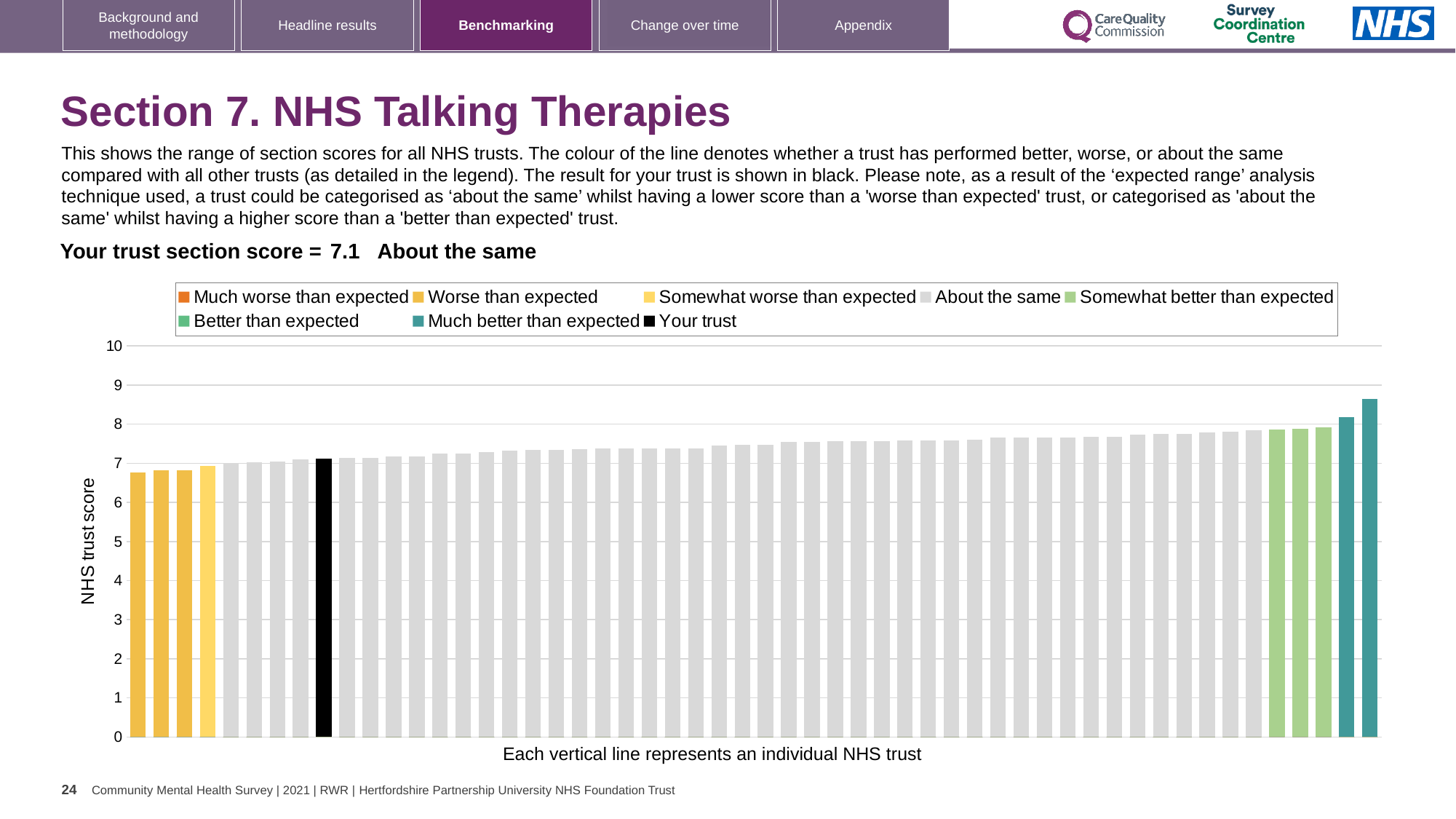
Which category is your trust placed in for this section? About the same How many bars are coloured as 'Much better than expected'? 2 What kind of chart is shown on the slide? bar chart How many entries does the chart legend list? 8 Is the value for your trust greater or less than 5? greater Is the tallest bar in the chart greater or less than 8? greater What colour is the bar representing your trust? black Do the bar values rise or fall from left to right along the x axis? rise What is the section score for your trust? 7.1 Which legend category does the tallest bar belong to? Much better than expected Is the shortest bar in the chart greater or less than 7? less What is the label on the vertical axis of the chart? NHS trust score